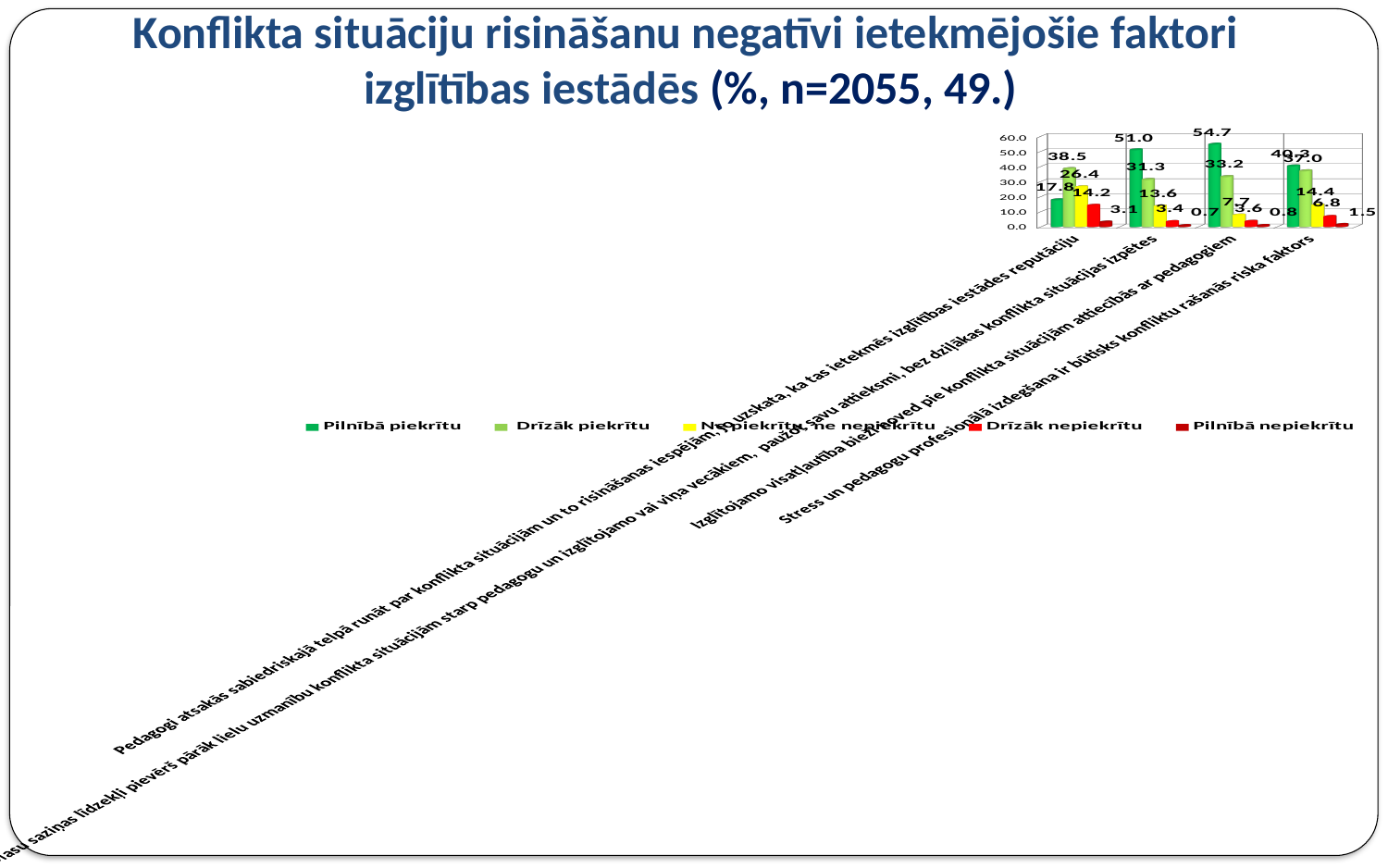
What is the value of "Pilnībā piekrītu" for the factor "Izglītojamo visatļautība biežāk noved pie konflikta situācijām attiecībās ar pedagogiem"? 54.7 Which factor has the lowest "Pilnībā piekrītu" value? Pedagogi atsakās sabiedriskajā telpā runāt par konflikta situācijām un to risināšanas iespējām, jo uzskata, ka tas ietekmēs izglītības iestādes reputāciju Which factor has the highest "Pilnībā piekrītu" value? Izglītojamo visatļautība bieži noved pie konflikta situācijām attiecībās ar pedagogiem How many series does the legend list? 5 What is the difference between the "Pilnībā piekrītu" values for "Izglītojamo visatļautība..." (54.7) and "Masu saziņas līdzekļi..." (51.0)? 3.7 How many categories (factors) are plotted on the x axis? 4 What colour represents the "Ne piekrītu, ne nepiekrītu" series? yellow What is the value of "Pilnībā piekrītu" for the factor "Masu saziņas līdzekļi pievērš pārāk lielu uzmanību konflikta situācijām..."? 51.0 For the factor "Pedagogi atsakās sabiedriskajā telpā runāt...", which is larger: "Drīzāk piekrītu" or "Pilnībā piekrītu"? Drīzāk piekrītu What is the value of "Pilnībā nepiekrītu" for the factor "Stress un pedagogu profesionālā izdegšana ir būtisks konfliktu rašanās riska faktors"? 1.5 What type of chart is shown on the slide? bar chart What is the value of "Drīzāk piekrītu" for the factor "Pedagogi atsakās sabiedriskajā telpā runāt par konflikta situācijām..."? 38.5